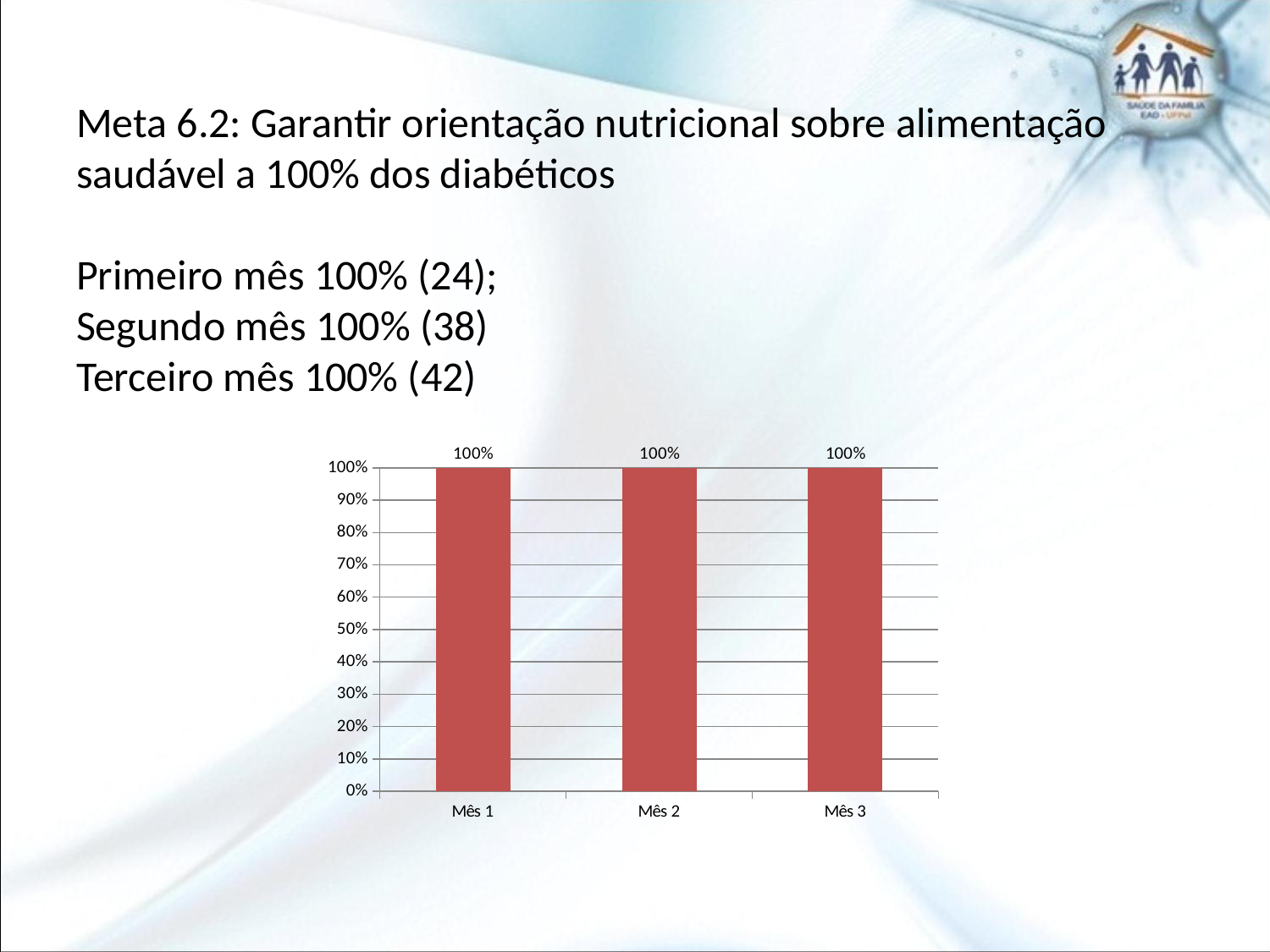
Do the values rise, fall or stay the same from Mês 1 to Mês 3? Stay the same What is the value shown for Mês 2? 100% How many categories are plotted on the x axis of the chart? 3 What is the value shown for Mês 1? 100% Is the value for Mês 2 greater or less than 50%? greater What kind of chart is shown on the slide? Bar chart Is the value for Mês 1 greater or less than 90%? greater What colour are the bars in the chart? Red What is the difference between the values for Mês 3 and Mês 1? 0% What is the value shown for Mês 3? 100% What is the highest tick label on the y axis of the chart? 100%